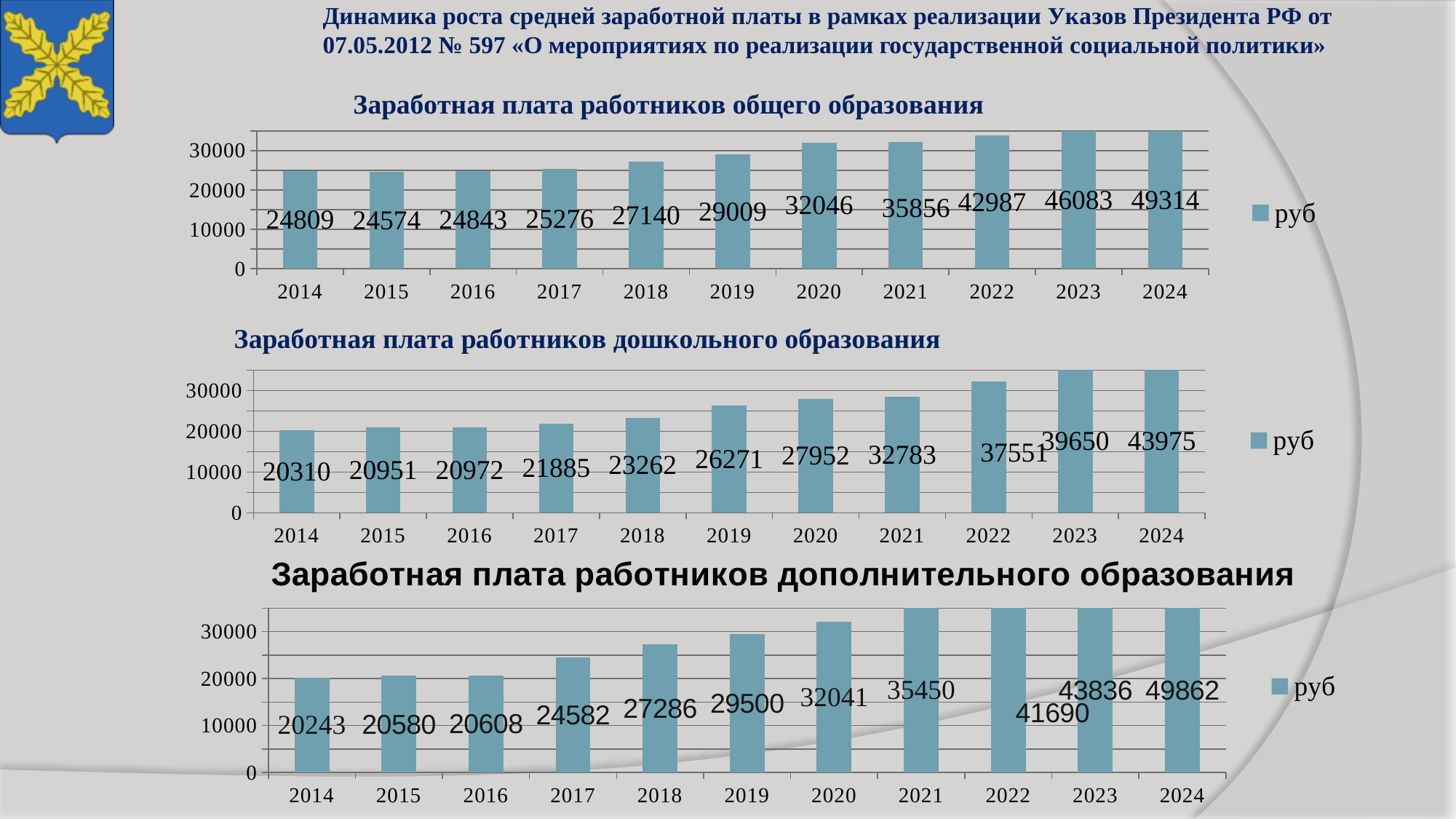
What is the legend entry shown for the chart 'Заработная плата работников дополнительного образования'? руб In the chart 'Заработная плата работников общего образования', what is the difference between the values for 2024 and 2014? 24505 In the chart 'Заработная плата работников дошкольного образования', is the value for 2019 greater or less than 20000? greater In the chart 'Заработная плата работников дополнительного образования', which is larger, the value for 2017 or the value for 2018? 2018 In the chart 'Заработная плата работников дополнительного образования', what is the value for 2022? 41690 In the chart 'Заработная плата работников дошкольного образования', what is the value for 2021? 32783 How many years are shown on the x axis of the chart 'Заработная плата работников общего образования'? 11 In the chart 'Заработная плата работников дополнительного образования', what is the difference between the values for 2023 and 2022? 2146 In the chart 'Заработная плата работников общего образования', what is the value for 2020? 32046 What type of chart is 'Заработная плата работников дошкольного образования'? bar chart In the chart 'Заработная плата работников дошкольного образования', which year has the highest value? 2024 In the chart 'Заработная плата работников общего образования', which year has the lowest value? 2015